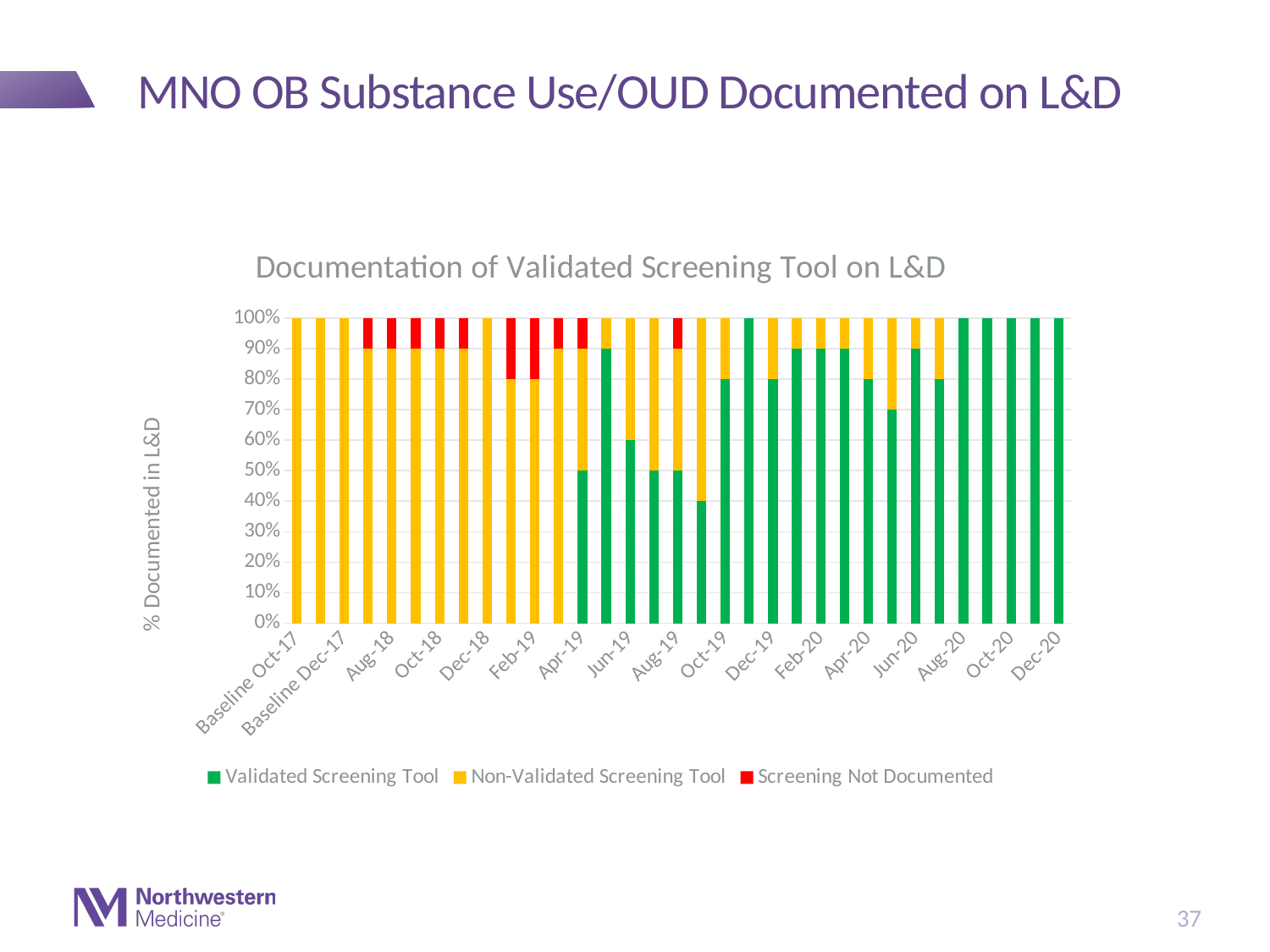
What is the title of the chart? Documentation of Validated Screening Tool on L&D What is the Validated Screening Tool value for Dec-20? 100% Which series makes up the entire bar for Baseline Dec-17? Non-Validated Screening Tool Is the Validated Screening Tool value for Feb-20 greater or less than 80%? greater What kind of chart is shown on the slide? Stacked bar chart What are the three series listed in the legend? Validated Screening Tool, Non-Validated Screening Tool, Screening Not Documented Is the Validated Screening Tool value for Jun-19 greater or less than 50%? greater Which is larger, the Validated Screening Tool value for Oct-19 or for Apr-19? Oct-19 How many series does the legend list? 3 What is the Non-Validated Screening Tool value for Baseline Oct-17? 100% What is the Validated Screening Tool value for Apr-19? 50% Does the Validated Screening Tool share generally rise or fall from Apr-19 to Dec-20? Rise